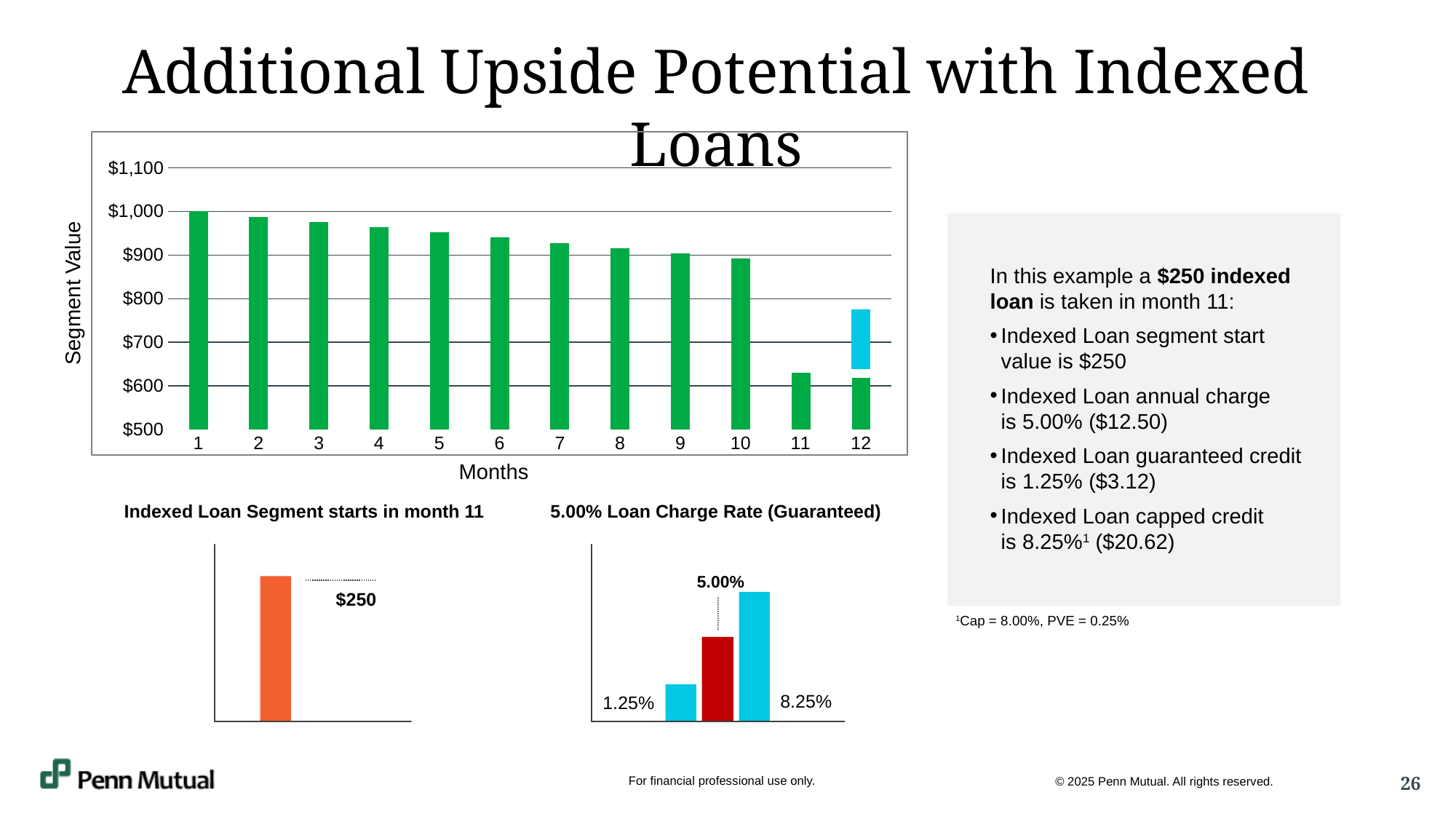
In the top Segment Value chart, is the green bar for month 11 greater or less than $700? less In the chart titled '5.00% Loan Charge Rate (Guaranteed)', what is the difference between the 8.25% bar and the 1.25% bar? 7.00% In the top Segment Value chart, which month has the highest green bar? 1 In the top Segment Value chart, do the green bars rise or fall from month 1 to month 10? Fall In the top Segment Value chart, which is larger, the bar for month 3 or the bar for month 8? Month 3 What kind of chart is the top chart showing Segment Value by Months? Bar chart In the top Segment Value chart, is the value for month 5 greater or less than $900? greater In the chart titled '5.00% Loan Charge Rate (Guaranteed)', what is the highest labelled value? 8.25% In the chart titled '5.00% Loan Charge Rate (Guaranteed)', how many bars are there? 3 What is the label on the vertical axis of the top chart? Segment Value In the top Segment Value chart, how many months are shown on the x axis? 12 In the chart titled 'Indexed Loan Segment starts in month 11', what value is labelled on the bar? $250